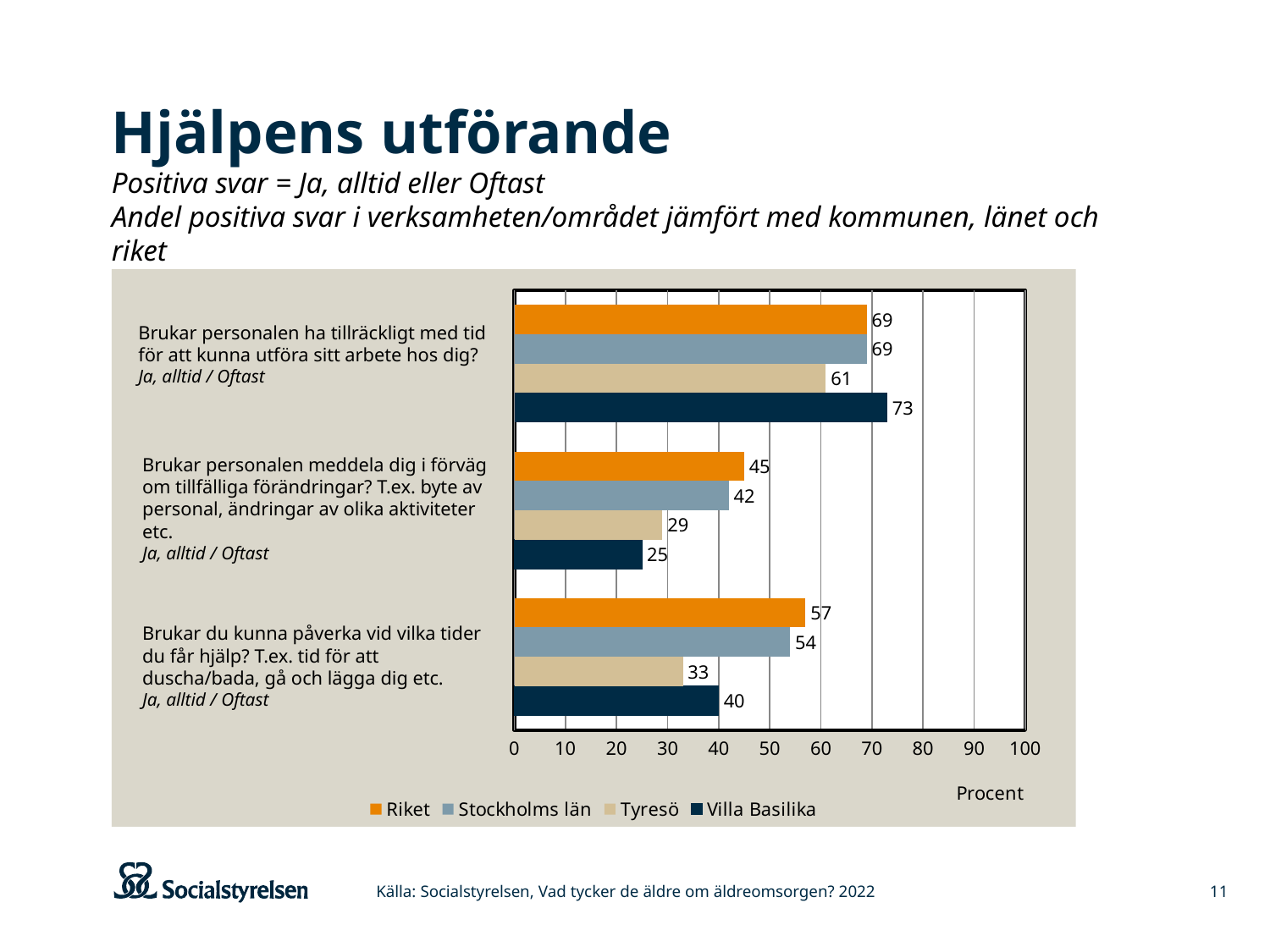
What is the value for Tyresö on the question about staff informing you in advance of temporary changes? 29 Is the value for Riket on the question about influencing at what times you get help greater or less than 50? greater What is the value for Villa Basilika on the question about whether staff usually have enough time to do their work? 73 How many questions (categories) are shown on the chart? 3 What unit label is shown below the x axis of the chart? Procent Which is larger on the question about influencing at what times you get help: Tyresö or Villa Basilika? Villa Basilika What kind of chart is shown on the slide? Bar chart Which series has the highest value on the question about staff having enough time to do their work? Villa Basilika How many series does the legend list? 4 Which series has the lowest value on the question about staff informing you in advance of temporary changes? Villa Basilika What is the difference between Riket and Villa Basilika on the question about staff informing you in advance of temporary changes? 20 What is the value for Stockholms län on the question about being able to influence at what times you get help? 54